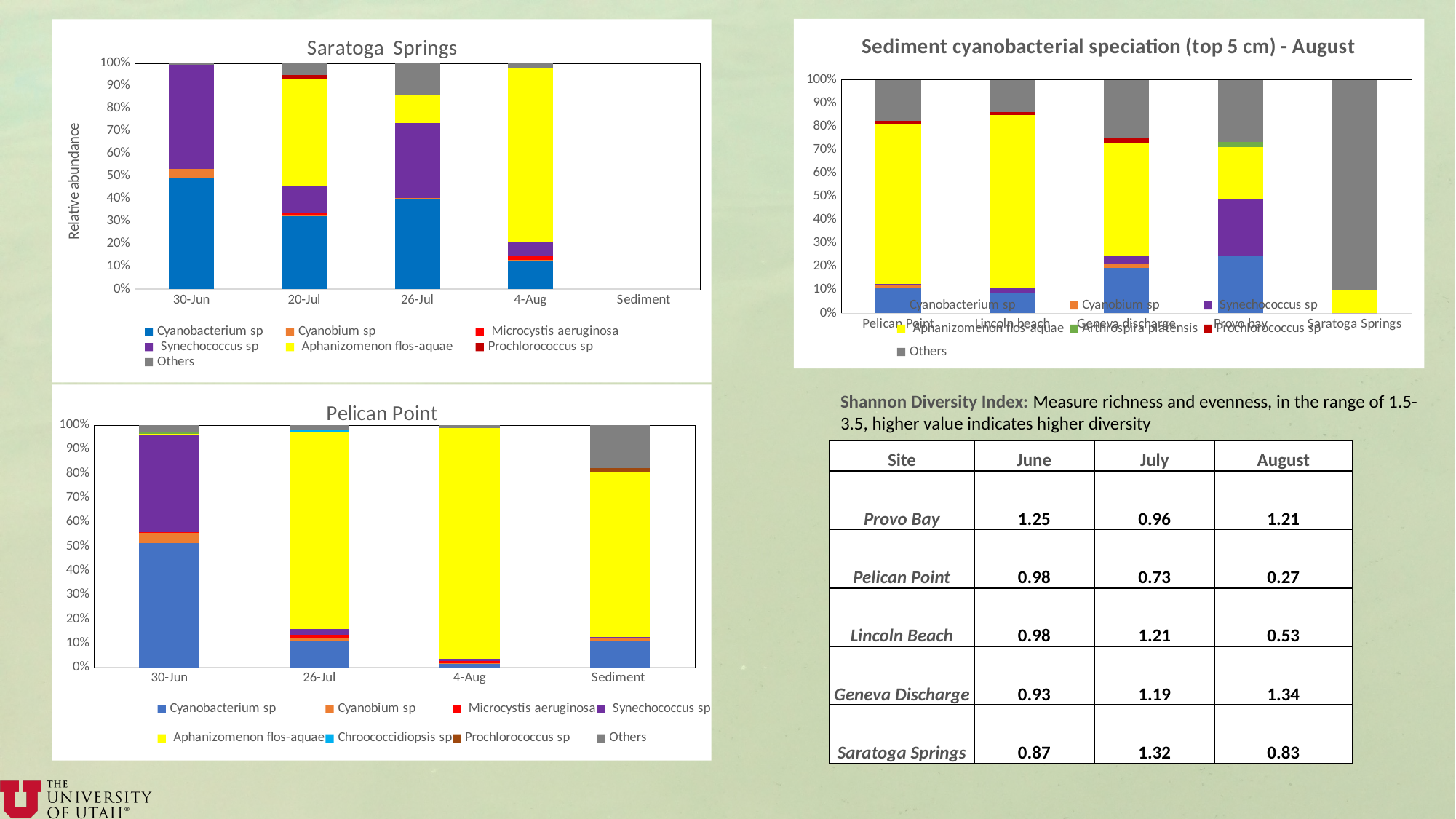
In the Saratoga Springs chart, which date has the largest Synechococcus sp share? 30-Jun In the Sediment cyanobacterial speciation (top 5 cm) - August chart, which site has the largest Others share? Saratoga Springs In the Saratoga Springs chart, which date has the largest Aphanizomenon flos-aquae share? 4-Aug In the Saratoga Springs chart, is the Cyanobacterium sp share on 4-Aug greater or less than 20%? less What is the y-axis label of the Saratoga Springs chart? Relative abundance How many categories are shown on the x axis of the Sediment cyanobacterial speciation (top 5 cm) - August chart? 5 How many series does the legend of the Saratoga Springs chart list? 7 How many series does the legend of the Pelican Point chart list? 8 What kind of chart is the Saratoga Springs chart? Stacked bar chart In the Sediment cyanobacterial speciation (top 5 cm) - August chart, is the Others share for Saratoga Springs greater or less than 80%? greater How many categories are shown on the x axis of the Pelican Point chart? 4